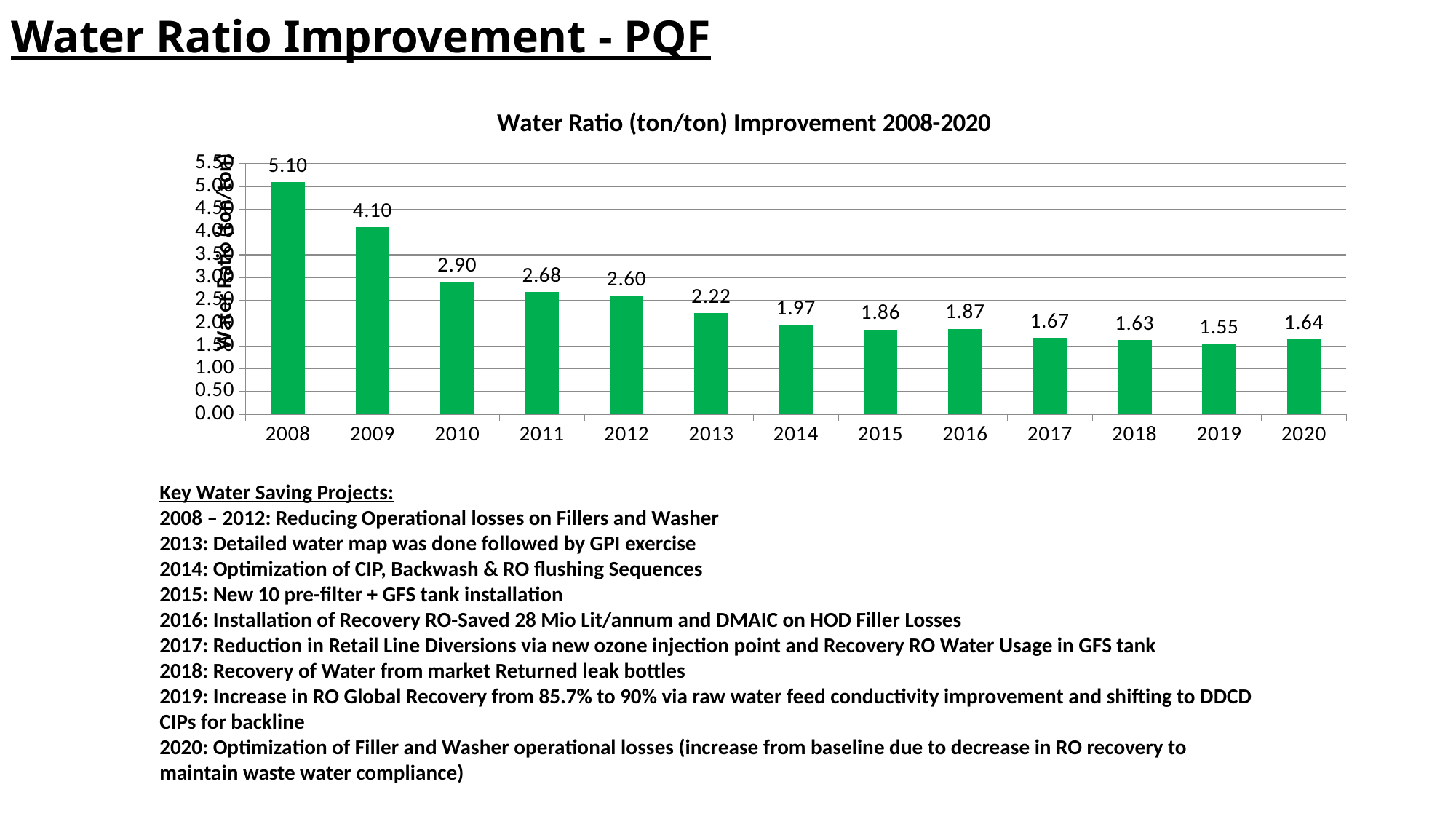
What is the water ratio value for 2008? 5.10 Which year has a larger water ratio, 2010 or 2014? 2010 Which year has the highest water ratio? 2008 What is the difference between the water ratio in 2012 and in 2013? 0.38 Is the value for 2011 greater or less than 3.00? less How many years are shown on the x axis of the chart? 13 What is the water ratio value for 2013? 2.22 What is the water ratio value for 2020? 1.64 Which year has the lowest water ratio? 2019 What is the difference between the water ratio in 2008 and in 2009? 1.00 What kind of chart is shown on the slide? bar chart Do the water ratio values generally rise or fall from 2008 to 2020? fall